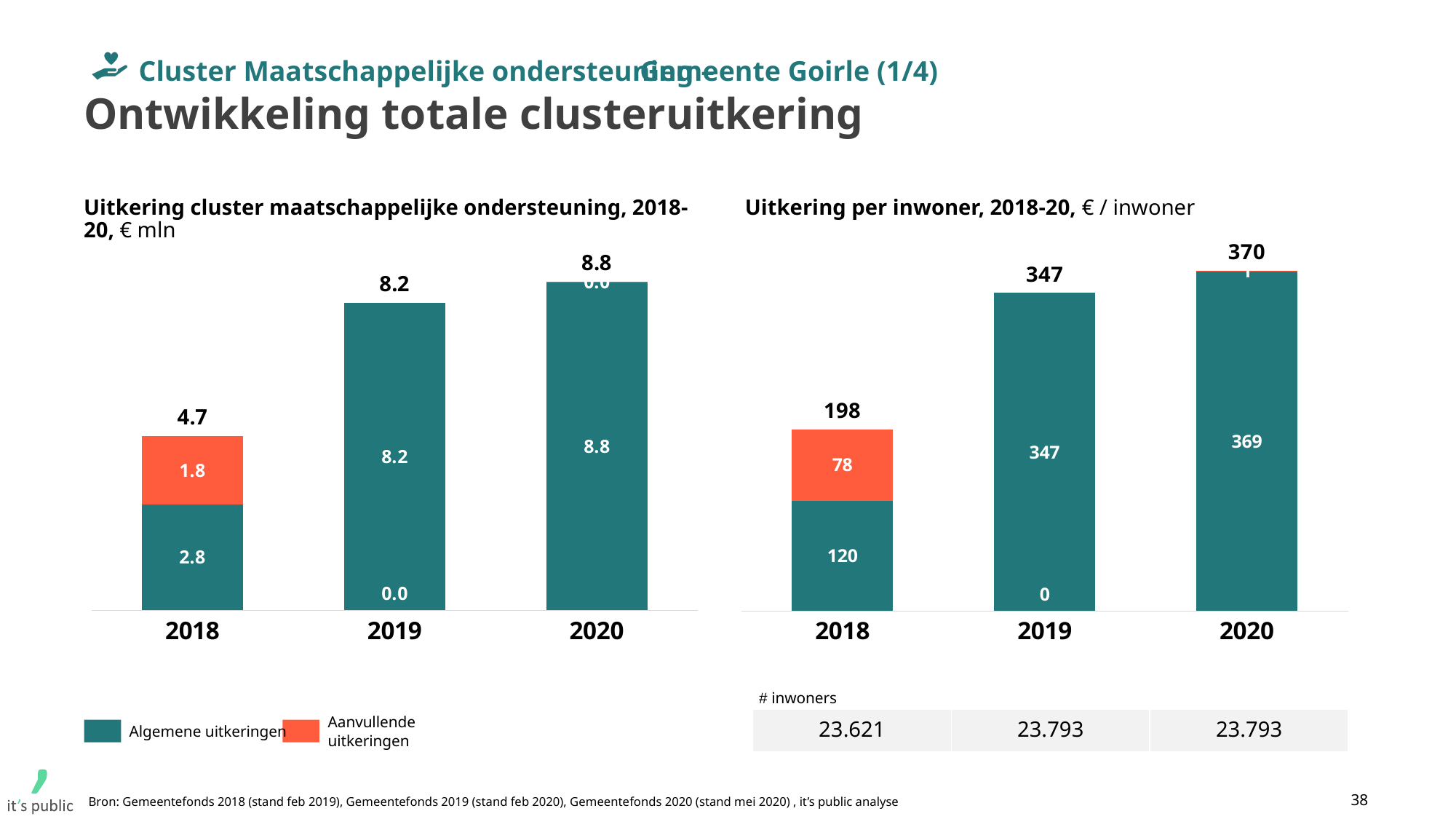
In the right chart (Uitkering per inwoner), do the totals rise or fall from 2018 to 2020? rise In the right chart (Uitkering per inwoner), which year has the lowest total? 2018 In the right chart (Uitkering per inwoner), what is the Aanvullende uitkeringen value for 2018? 78 In the right chart (Uitkering per inwoner), what is the difference between the 2019 total and the 2018 total? 149 In the left chart (Uitkering cluster maatschappelijke ondersteuning), what is the difference between the 2020 total and the 2019 total? 0.6 In the left chart (Uitkering cluster maatschappelijke ondersteuning), what is the Aanvullende uitkeringen value for 2018? 1.8 In the left chart (Uitkering cluster maatschappelijke ondersteuning), what is the total value for 2018? 4.7 In the right chart (Uitkering per inwoner), what is the total value for 2018? 198 How many series does the legend on the slide list? 2 In the left chart (Uitkering cluster maatschappelijke ondersteuning), what is the Algemene uitkeringen value for 2018? 2.8 In the right chart (Uitkering per inwoner), what is the Algemene uitkeringen value for 2020? 369 In the left chart (Uitkering cluster maatschappelijke ondersteuning), which year has the highest total? 2020